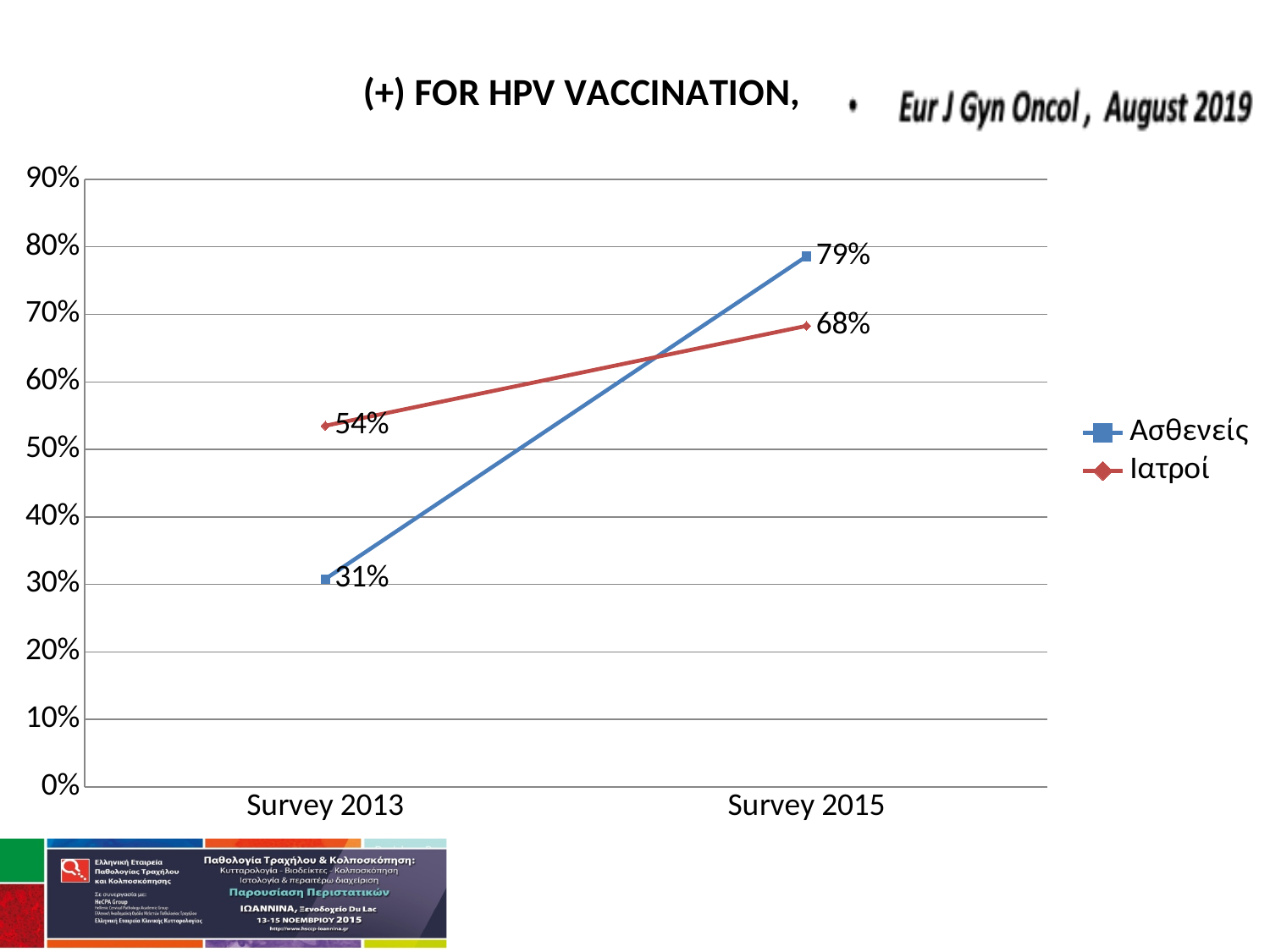
What is the difference between the Ασθενείς values in Survey 2015 and Survey 2013? 48% What is the difference between the Ασθενείς and Ιατροί values in Survey 2015? 11% What is the value for Ιατροί in Survey 2015? 68% What is the value for Ιατροί in Survey 2013? 54% Which series has the higher value in Survey 2015? Ασθενείς What kind of chart is shown on the slide? line chart What is the value for Ασθενείς in Survey 2015? 79% How many categories are shown on the x axis? 2 What is the value for Ασθενείς in Survey 2013? 31% Which series has the lower value in Survey 2013? Ασθενείς Does the value for Ιατροί rise or fall from Survey 2013 to Survey 2015? rise How many series does the legend list? 2